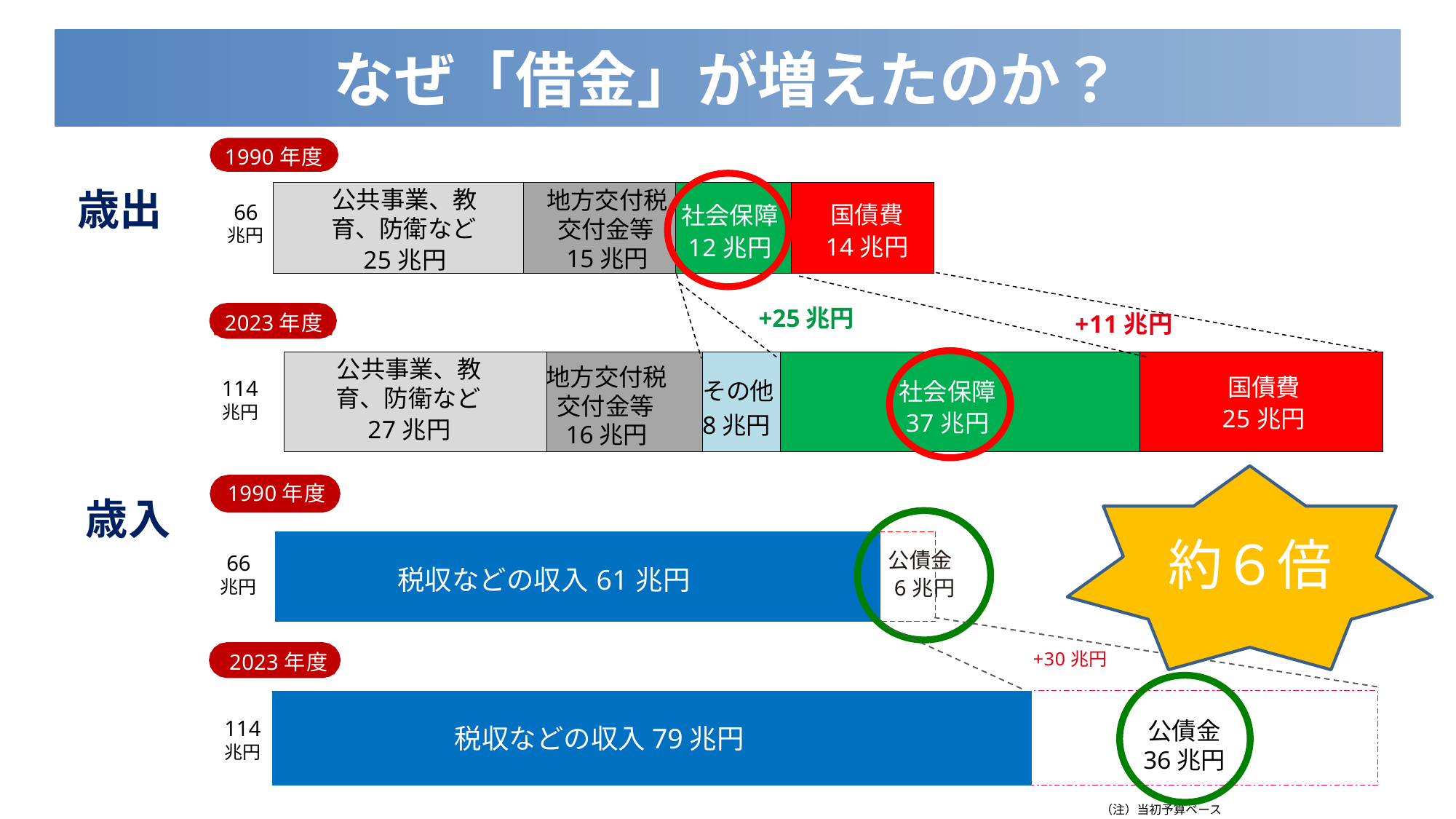
In the 歳出 (expenditure) chart, what is the total of the 2023年度 bar? 114 兆円 In the 歳出 (expenditure) chart, which is larger in 1990年度: 国債費 or 社会保障? 国債費 In the 歳出 (expenditure) chart, what is the value of 社会保障 in 1990年度? 12 兆円 In the 歳入 (revenue) chart, what is the value of 公債金 in 2023年度? 36 兆円 In the 歳出 (expenditure) chart, what is the difference between 社会保障 in 2023年度 and 社会保障 in 1990年度? 25 兆円 In the 歳出 (expenditure) chart, what is the value of 国債費 in 2023年度? 25 兆円 What kind of chart is used to show 歳出 and 歳入 on this slide? Stacked bar chart In the 歳出 (expenditure) chart, which segment is the smallest in the 2023年度 bar? その他 In the 歳出 (expenditure) chart, which segment is the largest in the 2023年度 bar? 社会保障 In the 歳入 (revenue) chart, what is the value of 税収などの収入 in 1990年度? 61 兆円 In the 歳入 (revenue) chart, what is the difference between 公債金 in 2023年度 and 公債金 in 1990年度? 30 兆円 In the 歳出 (expenditure) chart, how many segments make up the 2023年度 bar? 5